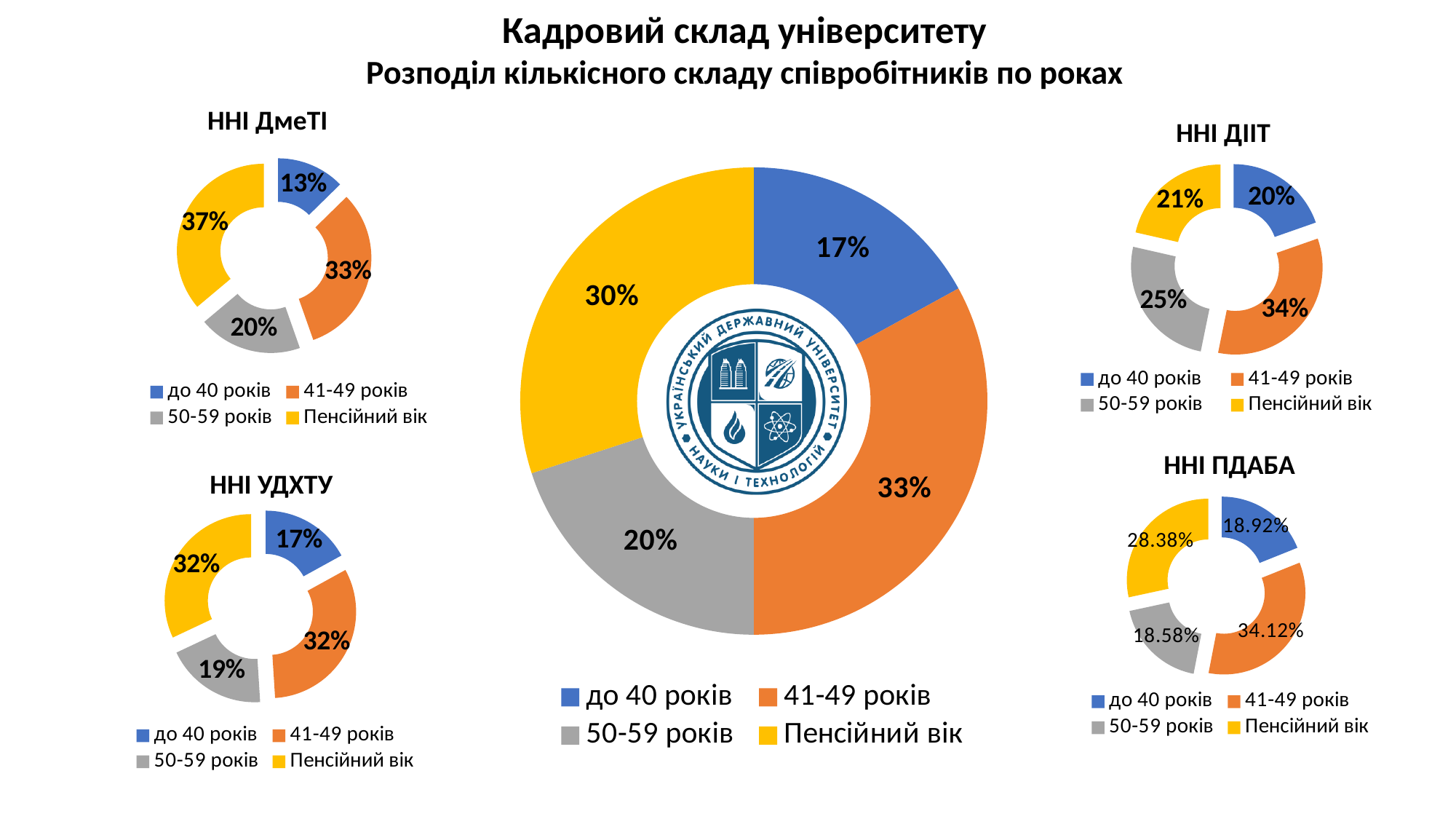
How many charts are shown on the slide? 5 In the ННІ ДІІТ chart, which is larger: the share for 'до 40 років' or the share for 'Пенсійний вік'? Пенсійний вік How many entries does the legend of the large central chart list? 4 In the ННІ ДмеТІ chart, what share is labelled for the 'Пенсійний вік' slice? 37% In the ННІ УДХТУ chart, which category has the smallest share? до 40 років In the ННІ ДІІТ chart, what share is labelled for the '50-59 років' slice? 25% In the large central chart, what is the difference between the '41-49 років' share and the '50-59 років' share? 13% In the large central chart, what share is labelled for the 'до 40 років' slice? 17% In the ННІ ПДАБА chart, what share is labelled for the '41-49 років' slice? 34.12% In the ННІ ДмеТІ chart, which category has the largest share? Пенсійний вік What kind of chart is the ННІ УДХТУ chart? Doughnut chart How many slices does the ННІ ПДАБА chart have? 4